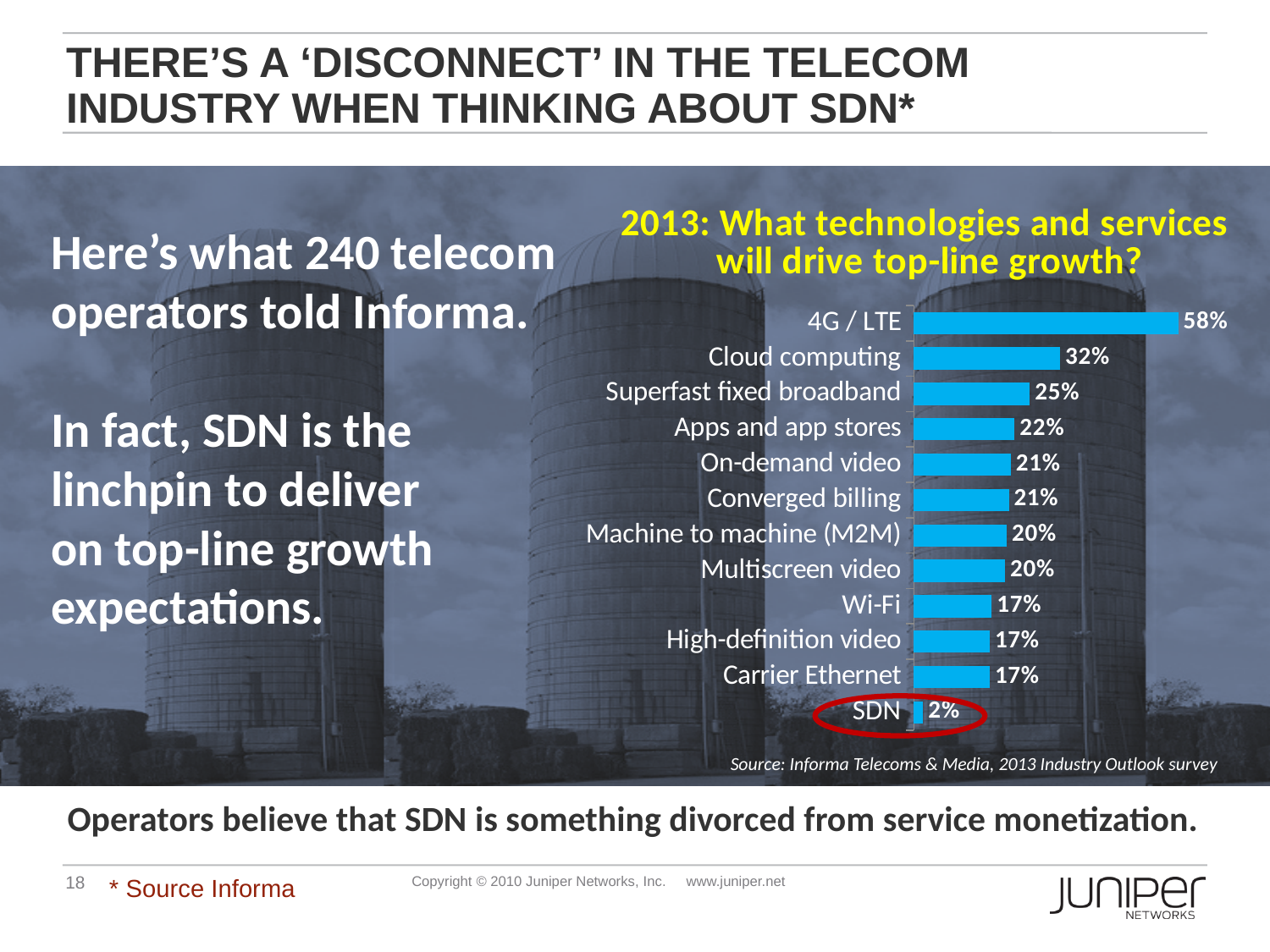
Which is larger, the value for Apps and app stores or the value for Wi-Fi? Apps and app stores What percentage is shown for 4G / LTE? 58% What percentage is shown for Machine to machine (M2M)? 20% What percentage is shown for Cloud computing? 32% What kind of chart is shown on the slide? Bar chart What percentage is shown for SDN? 2% What is the difference between the values for 4G / LTE and Cloud computing? 26% What is the difference between the values for Superfast fixed broadband and SDN? 23% Which category has the highest value? 4G / LTE How many categories are shown in the chart? 12 Which category has the lowest value? SDN What is the title of the chart? 2013: What technologies and services will drive top-line growth?